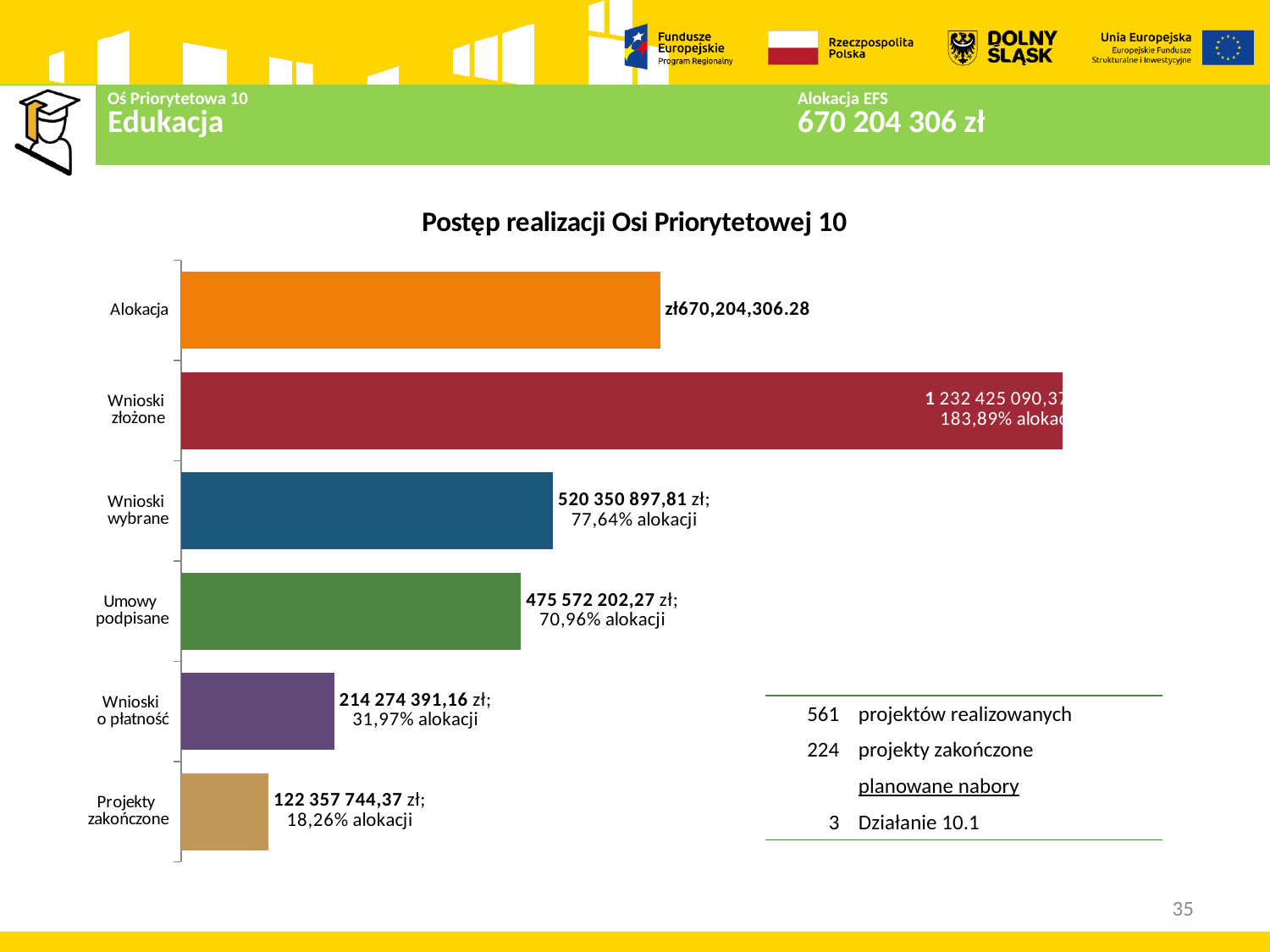
What percentage of the allocation do Projekty zakończone represent? 18,26% What is the title of the chart? Postęp realizacji Osi Priorytetowej 10 What is the value shown for Wnioski o płatność? 214 274 391,16 zł What percentage of the allocation do Umowy podpisane represent? 70,96% Which category has the longest bar? Wnioski złożone Which is larger, the value for Wnioski wybrane or the value for Umowy podpisane? Wnioski wybrane What is the value shown for Wnioski wybrane? 520 350 897,81 zł What is the value shown for Alokacja? zł670,204,306.28 What type of chart is shown on the slide? bar chart Which category has the shortest bar? Projekty zakończone Do the bar values rise or fall going down from Alokacja to Projekty zakończone, ignoring Wnioski złożone? fall How many categories are plotted in the chart? 6